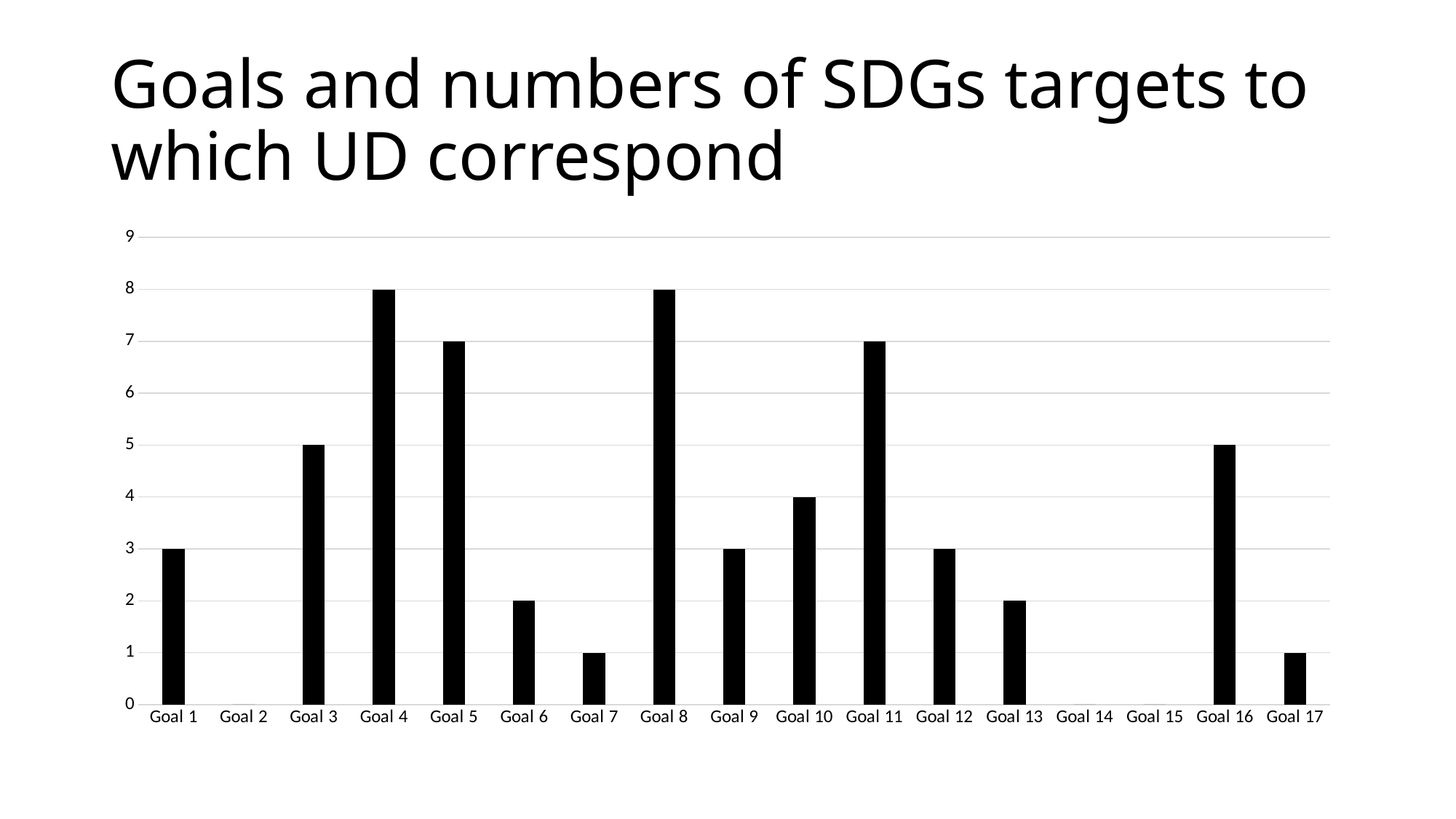
Which is larger, the value for Goal 3 or the value for Goal 9? Goal 3 What is the difference between the values for Goal 5 and Goal 6? 5 How many goals are listed along the x axis? 17 What is the value for Goal 11? 7 What is the title of the chart? Goals and numbers of SDGs targets to which UD correspond Is the value for Goal 13 greater or less than 4? less What type of chart is shown on the slide? Bar chart Which two goals share the highest value on the chart? Goal 4 and Goal 8 Which goals have no bar shown (a value of 0)? Goal 2, Goal 14 and Goal 15 What is the value for Goal 10? 4 What is the value for Goal 16? 5 What is the value for Goal 4? 8